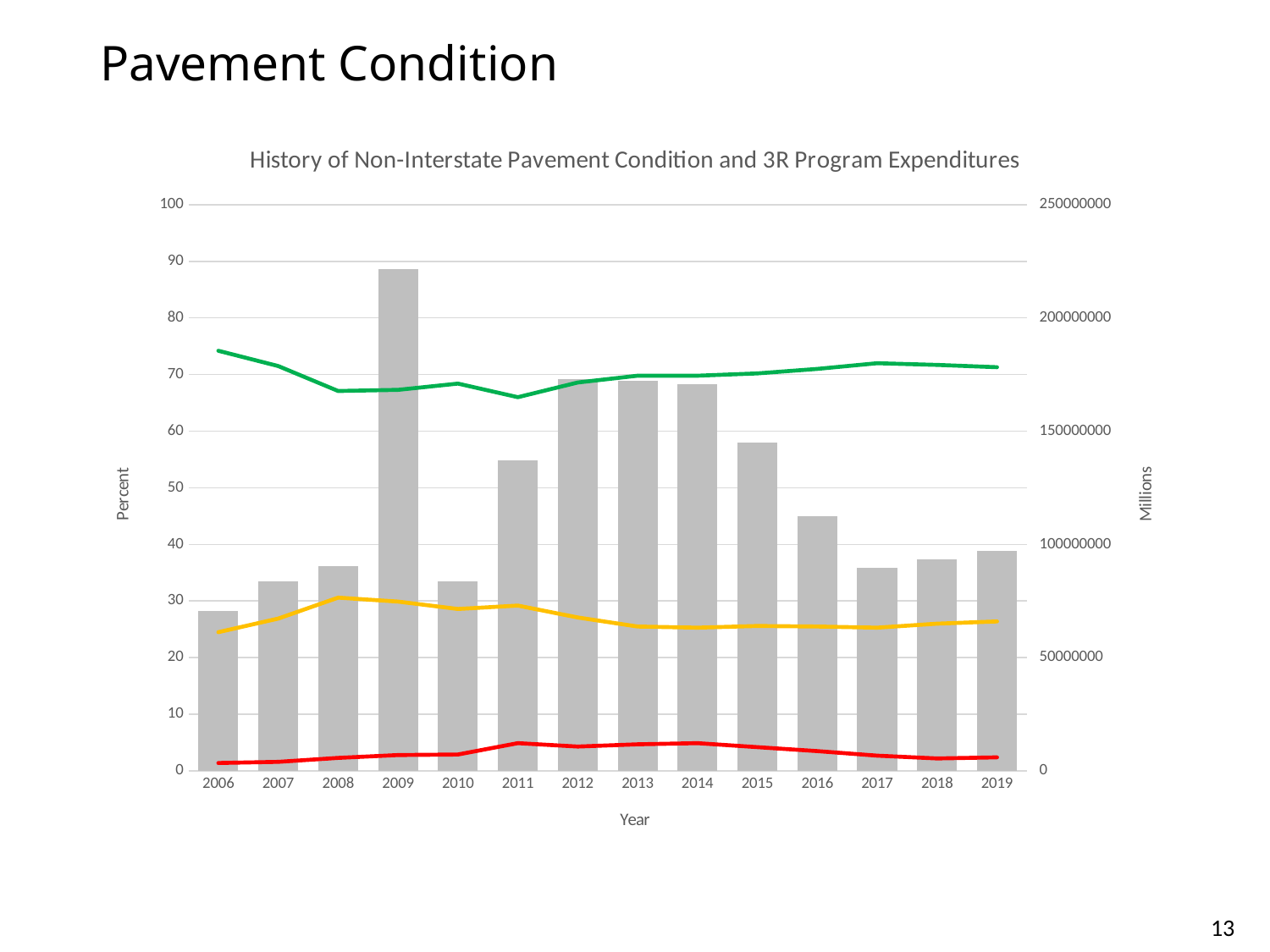
Is the yellow line's value for 2013 greater or less than 30 on the left axis? less Which bar is taller, 2016 or 2017? 2016 Which year has the tallest bar in the chart? 2009 What is the label on the left vertical axis of the chart? Percent What kind of chart is shown on the slide? Combined bar and line chart Do the bars rise or fall from 2014 to 2017? fall How many years are shown along the x axis of the chart? 14 Which year has the shortest bar in the chart? 2006 Is the bar for 2006 greater or less than 100000000 on the right axis? less What is the title of the chart? History of Non-Interstate Pavement Condition and 3R Program Expenditures Is the green line's value for 2006 greater or less than 70 on the left axis? greater